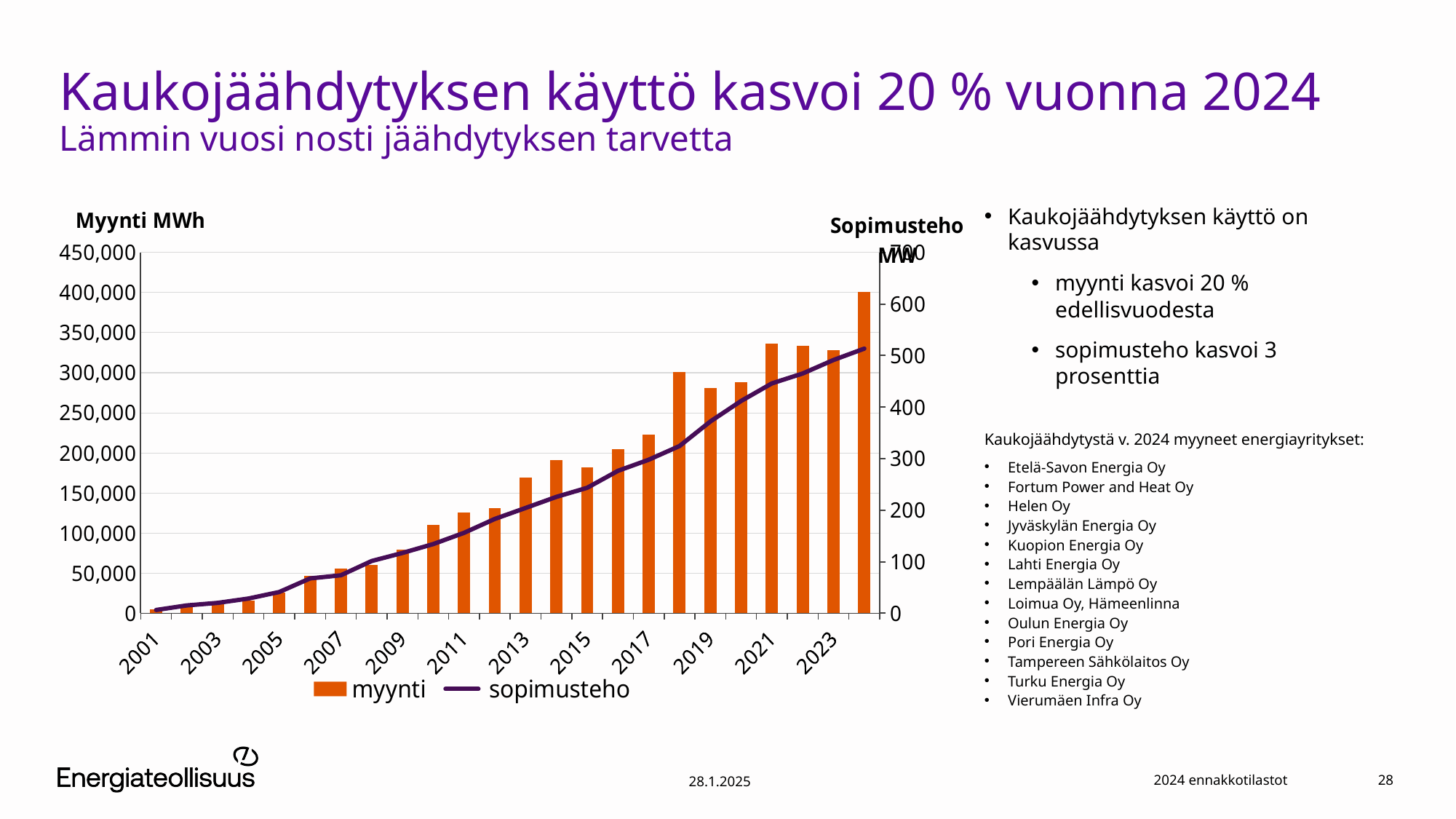
Is the myynti value for 2017 greater or less than 250,000? less How many series does the legend list? 2 What is the title of the left vertical axis? Myynti MWh Is the sopimusteho value for 2011 greater or less than 200? less Which year has the larger myynti value, 2019 or 2021? 2021 Do the sopimusteho values generally rise or fall from 2001 to the end of the series? rise Which year has the lowest myynti value? 2001 Is the myynti value for 2005 greater or less than 50,000? less What kind of chart is shown on the slide? A bar chart combined with a line What are the two series named in the legend? myynti and sopimusteho